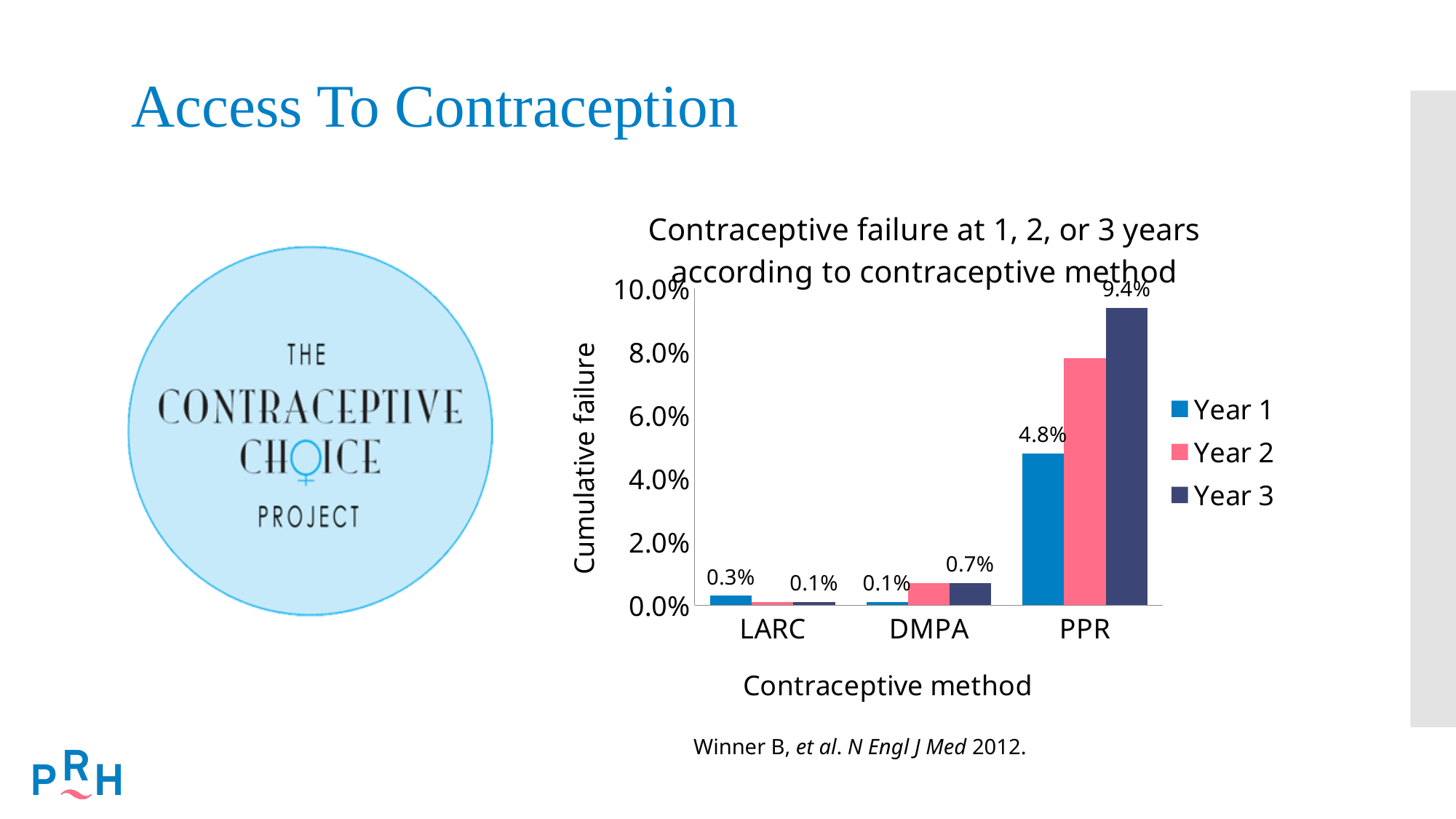
Which has a higher Year 1 cumulative failure, LARC or DMPA? LARC Which contraceptive method has the highest cumulative failure in Year 3? PPR What is the cumulative failure for LARC in Year 1? 0.3% What is the cumulative failure for PPR in Year 1? 4.8% How many contraceptive methods are shown on the x axis? 3 What is the cumulative failure for PPR in Year 3? 9.4% What kind of chart is shown on the slide? Bar chart Which contraceptive method has the lowest cumulative failure in Year 1? DMPA What is the cumulative failure for DMPA in Year 3? 0.7% How many series does the legend list? 3 What is the difference between the Year 3 and Year 1 cumulative failure for PPR? 4.6% Is the Year 2 cumulative failure for PPR greater or less than 6.0%? greater